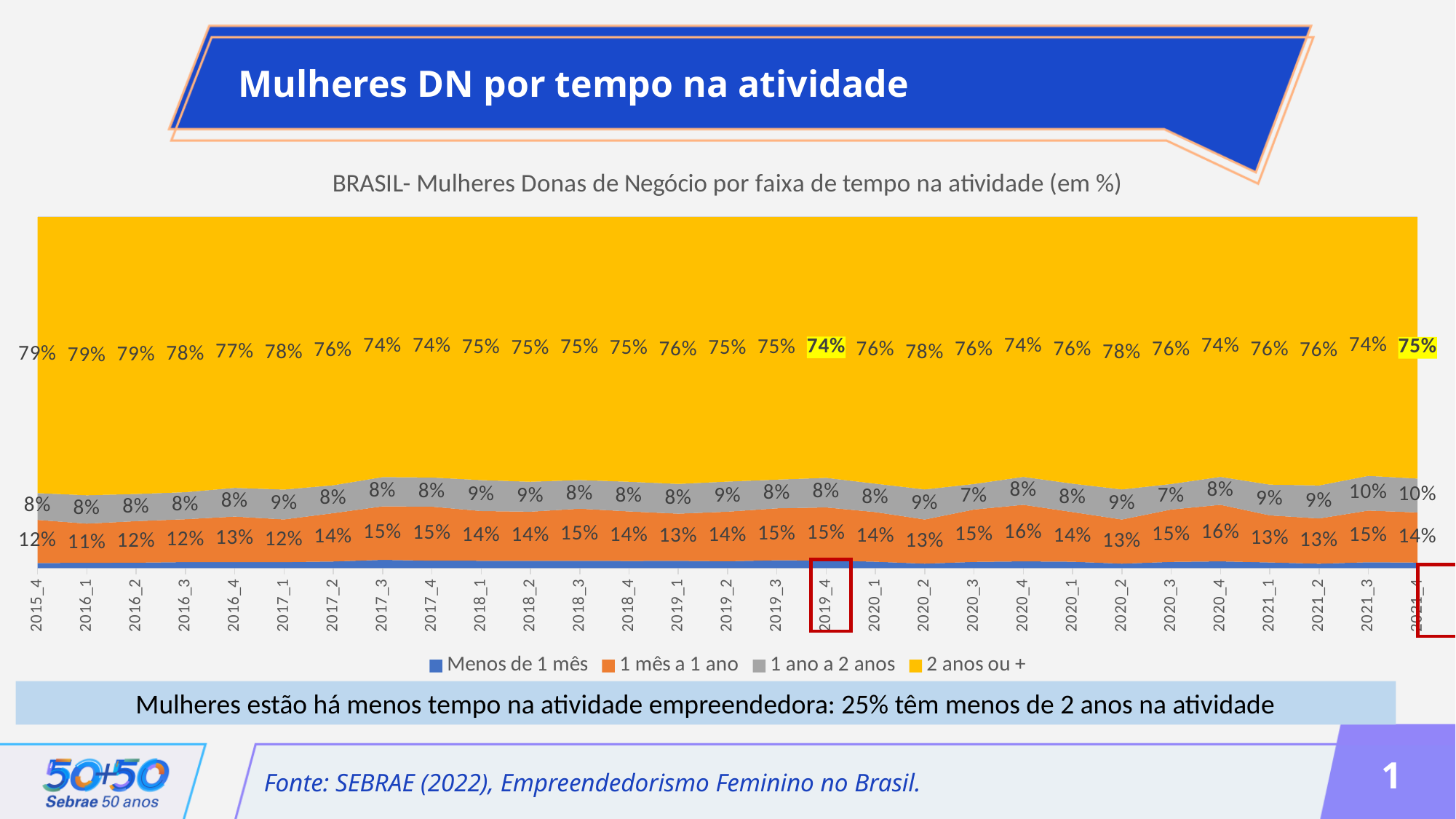
What type of chart is shown on the slide? Stacked area chart What is the title of the chart? BRASIL- Mulheres Donas de Negócio por faixa de tempo na atividade (em %) How many series does the legend list? 4 Does the '2 anos ou +' series rise or fall from 2015_4 to 2021_4? Fall What is the highest value shown for the '2 anos ou +' series? 79% What is the difference between the '2 anos ou +' values for 2015_4 and 2021_4? 4 percentage points Which is larger for the '2 anos ou +' series: 2015_4 or 2021_4? 2015_4 What is the value of the '2 anos ou +' series for 2015_4? 79% What is the value of the '2 anos ou +' series for 2019_4? 74% What is the value of the '1 mês a 1 ano' series for 2015_4? 12% What is the value of the '1 ano a 2 anos' series for 2021_4? 10% What is the value of the '2 anos ou +' series for 2021_4? 75%